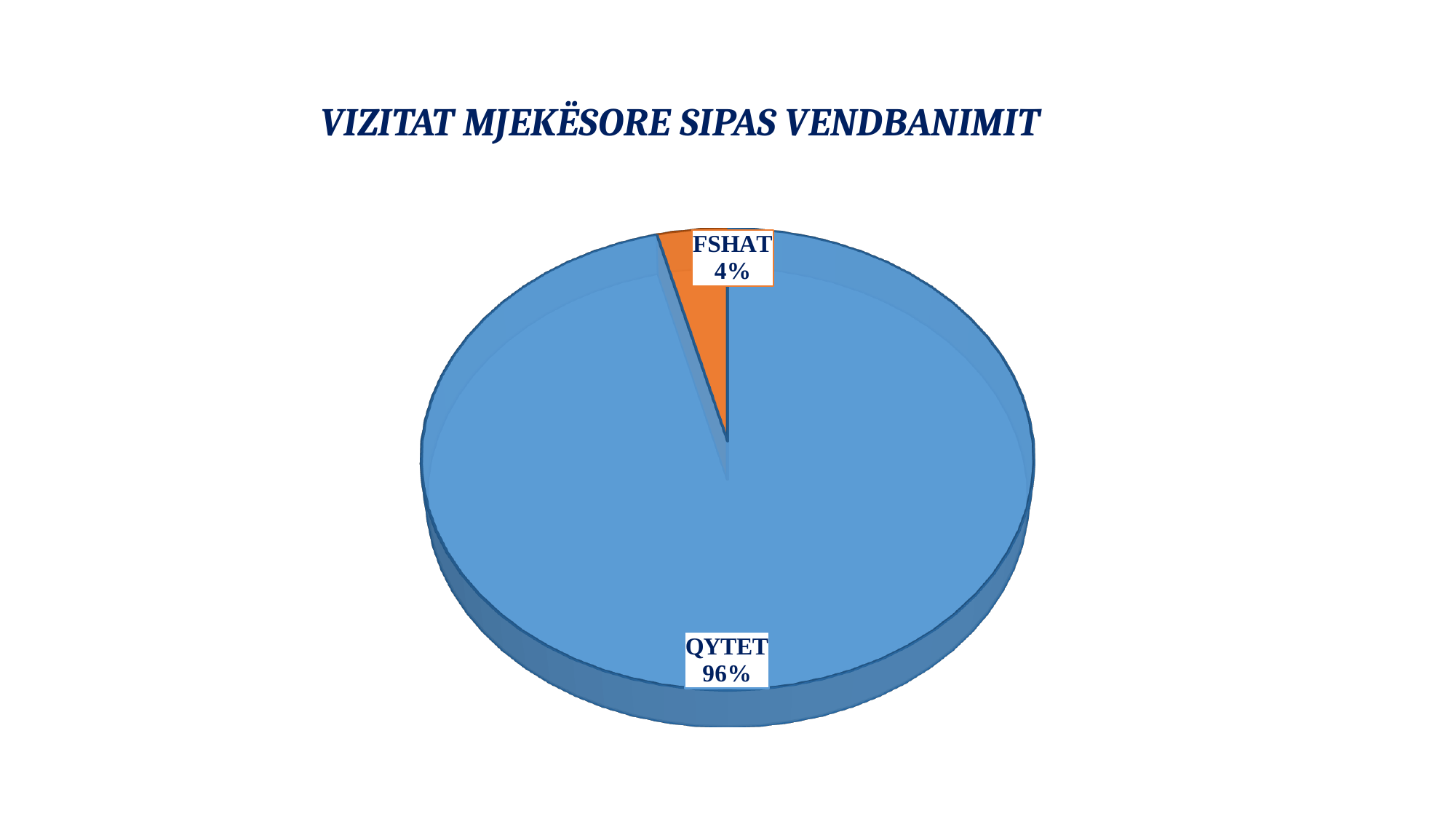
Which category has the smallest slice of the pie? FSHAT What colour is the FSHAT slice? orange What share of the pie does QYTET represent? 96% What share of the pie does FSHAT represent? 4% How many slices does the pie chart have? 2 What is the difference in percentage points between QYTET and FSHAT? 92 What kind of chart is shown on the slide? pie chart What is the title of the chart? VIZITAT MJEKËSORE SIPAS VENDBANIMIT Which is larger, the share for QYTET or the share for FSHAT? QYTET Which category has the largest slice of the pie? QYTET